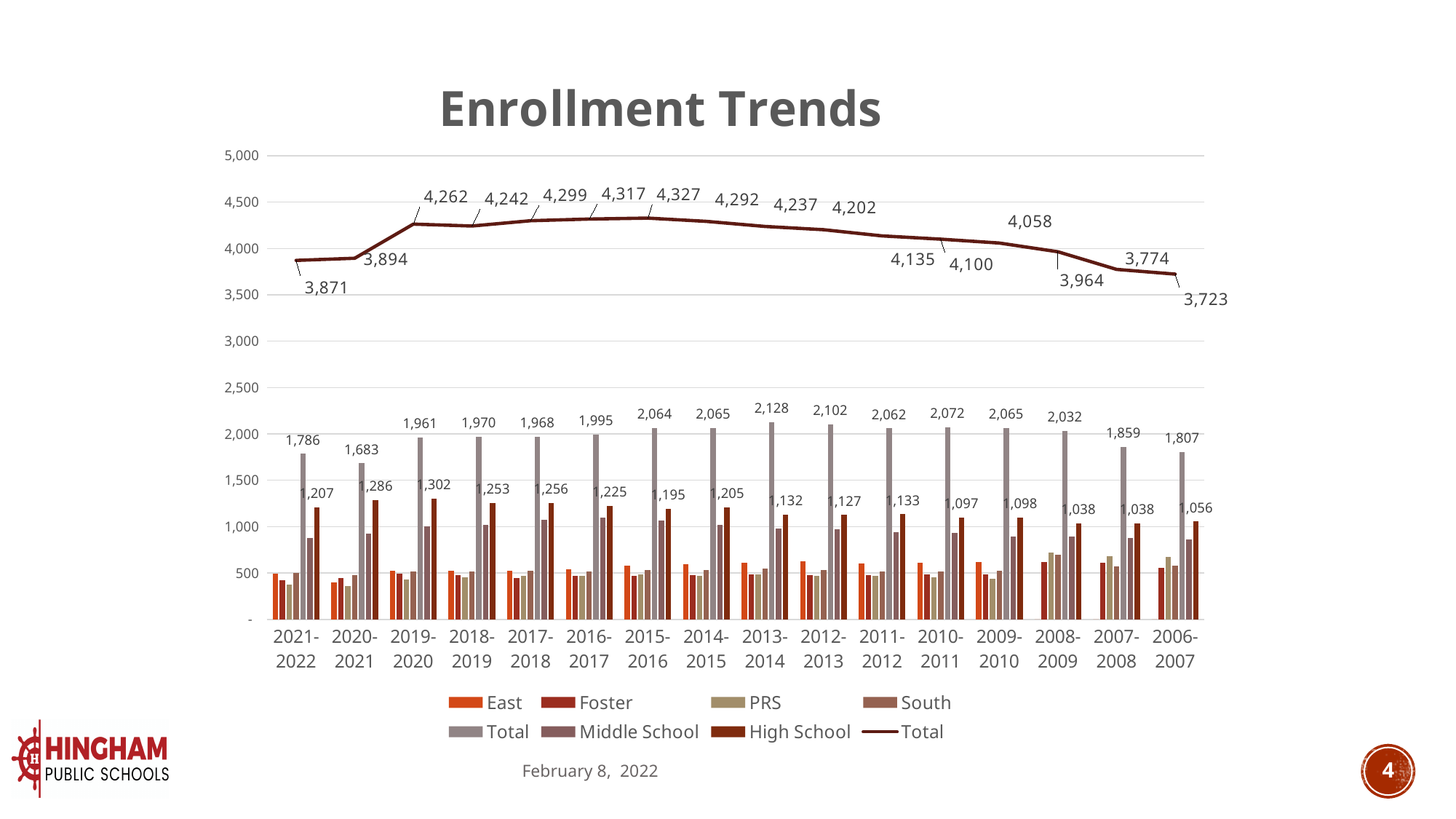
Which school year has the highest value on the Total line? 2015-2016 What is the title of the chart? Enrollment Trends What is the High School enrollment for 2019-2020? 1,302 Which school year has the lowest value on the Total line? 2006-2007 What kind of chart is shown on the slide? Combination bar and line chart What is the value of the grey Total bar for 2013-2014? 2,128 How many school years are shown on the x axis? 16 What is the Total line value for the 2015-2016 school year? 4,327 How many series does the legend list? 8 Is the Middle School value for 2021-2022 greater or less than 1,000? less Which is larger, the High School enrollment for 2020-2021 or for 2021-2022? 2020-2021 What is the difference between the Total line values for 2021-2022 and 2006-2007? 148